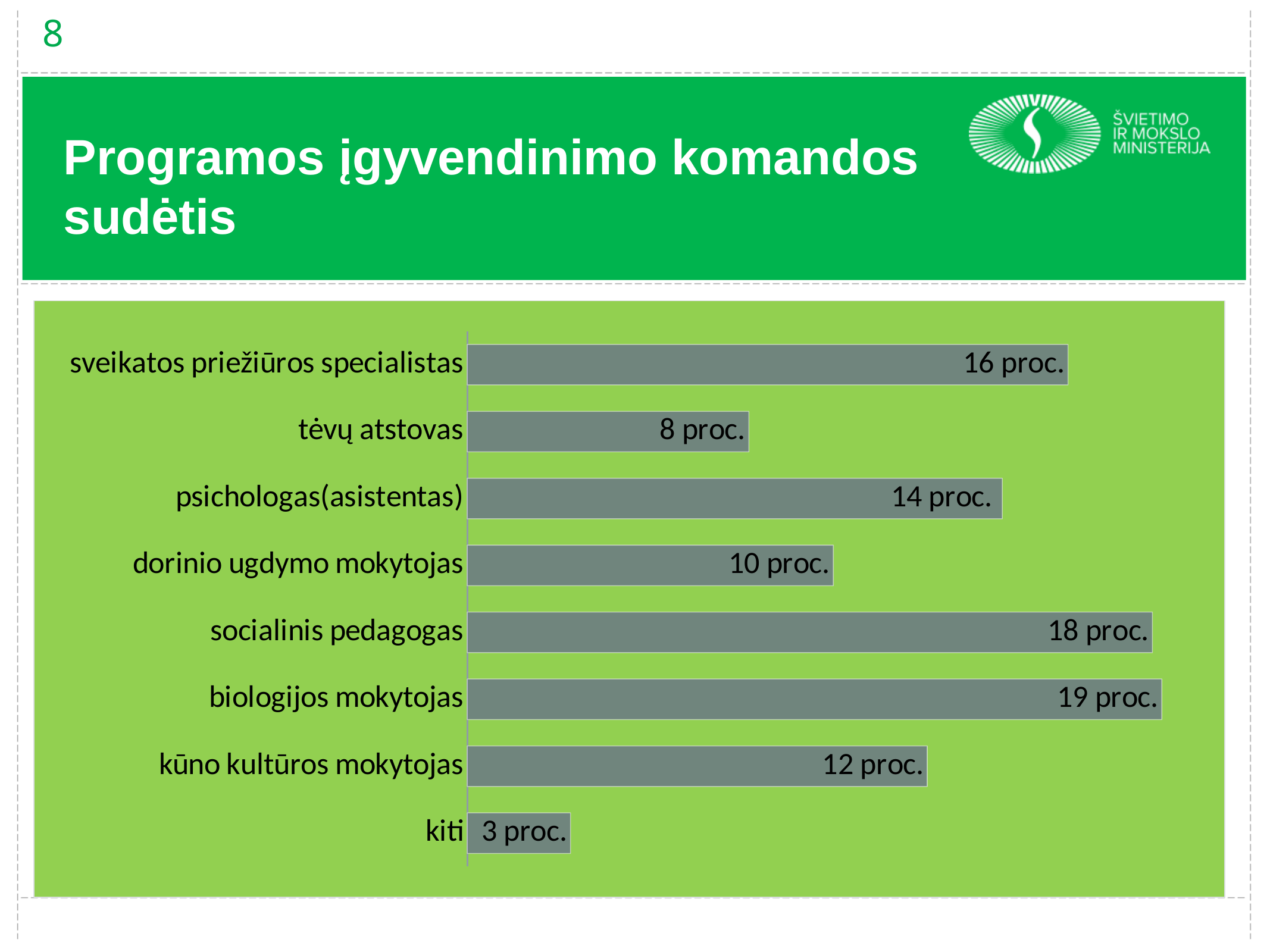
What is the value for kūno kultūros mokytojas? 12 proc. How many categories are shown in the chart? 8 Which category has the lowest value? kiti What is the value for psichologas(asistentas)? 14 proc. What is the title of the slide containing the chart? Programos įgyvendinimo komandos sudėtis Which category has the highest value? biologijos mokytojas What is the value for sveikatos priežiūros specialistas? 16 proc. What is the difference between the values for biologijos mokytojas and kiti? 16 proc. What kind of chart is shown on the slide? bar chart What is the difference between the values for socialinis pedagogas and dorinio ugdymo mokytojas? 8 proc. Which is larger, the value for sveikatos priežiūros specialistas or the value for psichologas(asistentas)? sveikatos priežiūros specialistas What is the value for tėvų atstovas? 8 proc.